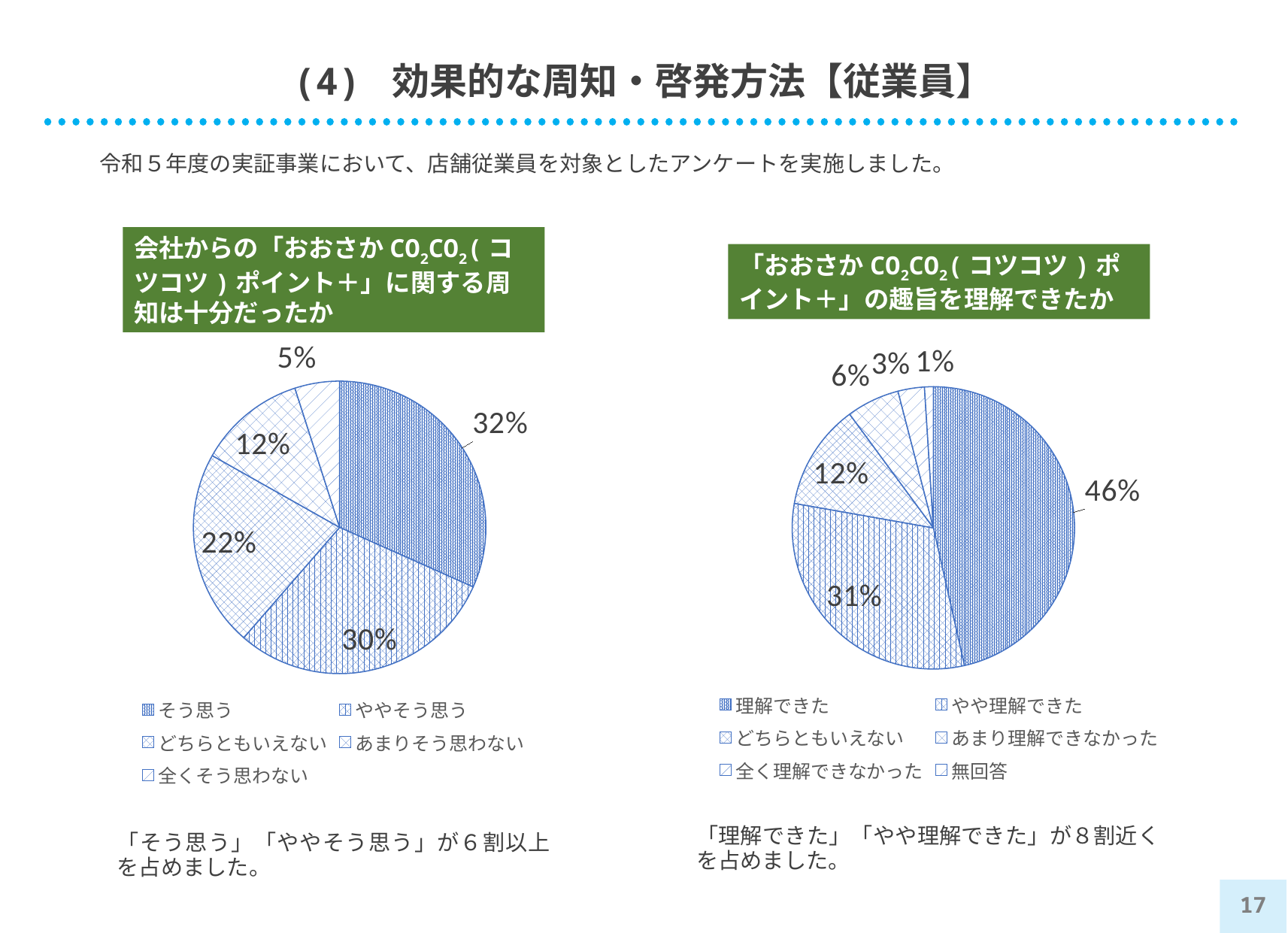
In the right pie chart (「おおさかCO2CO2(コツコツ)ポイント＋」の趣旨を理解できたか), what share is labelled for 理解できた? 46% In the right pie chart, which category has the largest share? 理解できた In the left pie chart (会社からの「おおさかCO2CO2(コツコツ)ポイント＋」に関する周知は十分だったか), what share is labelled for そう思う? 32% In the right pie chart, what is the combined share of 理解できた and やや理解できた? 77% In the right pie chart, which is larger: the share for どちらともいえない or the share for あまり理解できなかった? どちらともいえない In the right pie chart, what share is labelled for 無回答? 1% In the left pie chart, what is the difference between the shares for そう思う and ややそう思う? 2% In the left pie chart, which category has the smallest share? 全くそう思わない In the left pie chart, what share is labelled for 全くそう思わない? 5% In the left pie chart, how many categories does the legend list? 5 What type of chart is used on the right side of the slide? Pie chart In the left pie chart, which category has the largest share? そう思う